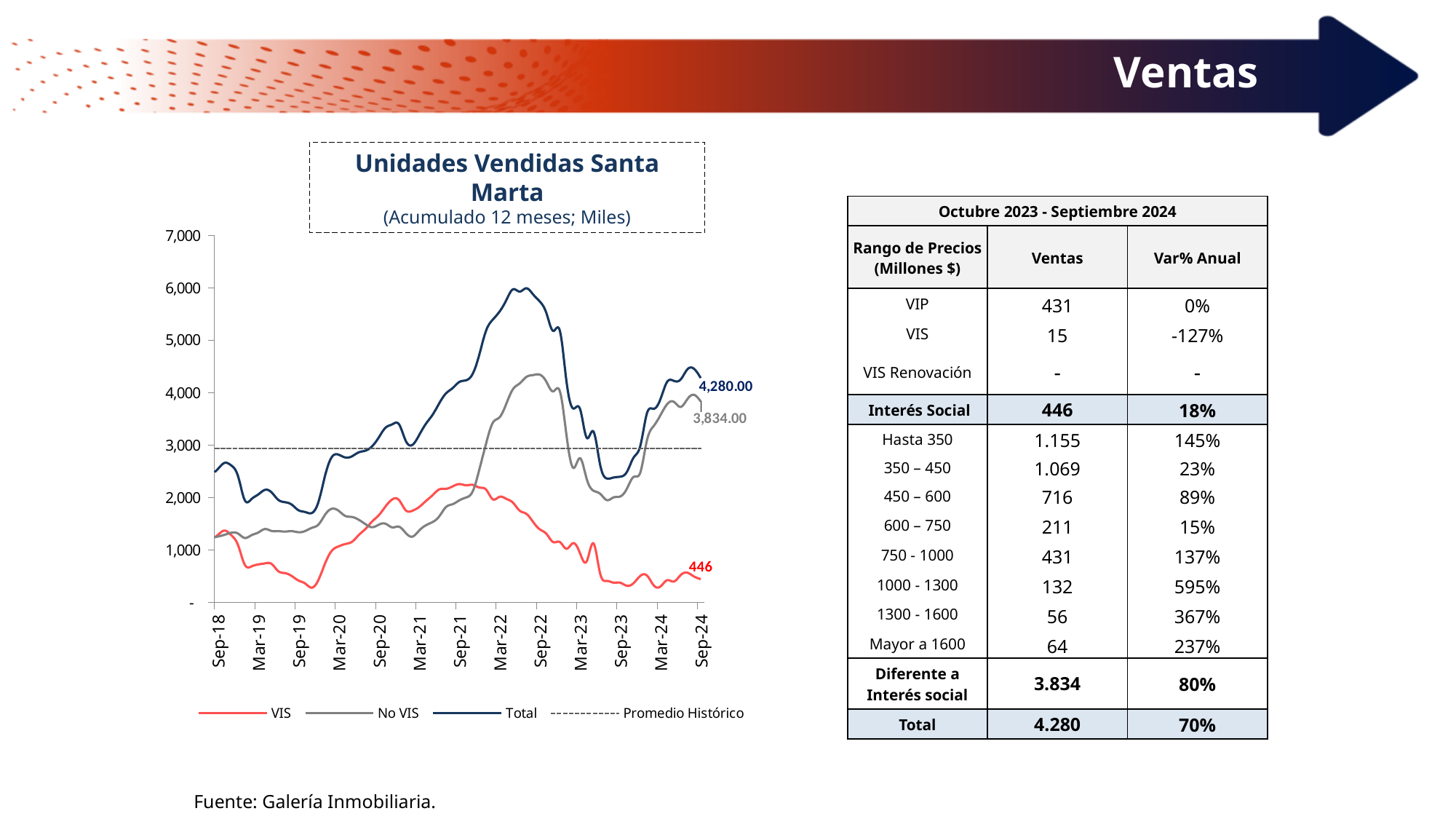
In the 'Unidades Vendidas Santa Marta' chart, which series has the highest value at Sep-24? Total In the 'Unidades Vendidas Santa Marta' chart, what is the value of the No VIS series at Sep-24? 3,834.00 What kind of chart is 'Unidades Vendidas Santa Marta'? Line chart How many series does the legend of the 'Unidades Vendidas Santa Marta' chart list? 4 In the 'Unidades Vendidas Santa Marta' chart, what is the difference between the Total and No VIS values at Sep-24? 446.00 In the 'Unidades Vendidas Santa Marta' chart, what is the value of the Total series at Sep-24? 4,280.00 In the 'Unidades Vendidas Santa Marta' chart, does the VIS line rise or fall between Sep-21 and Sep-24? fall In the 'Unidades Vendidas Santa Marta' chart, what is the value of the VIS series at Sep-24? 446 What subtitle appears under the title of the 'Unidades Vendidas Santa Marta' chart? (Acumulado 12 meses; Miles) In the 'Unidades Vendidas Santa Marta' chart, is the peak of the Total line greater or less than 5,000? greater In the 'Unidades Vendidas Santa Marta' chart, is the VIS value at Sep-24 greater or less than 1,000? less In the 'Unidades Vendidas Santa Marta' chart, which is larger at Sep-24: the VIS value or the No VIS value? No VIS